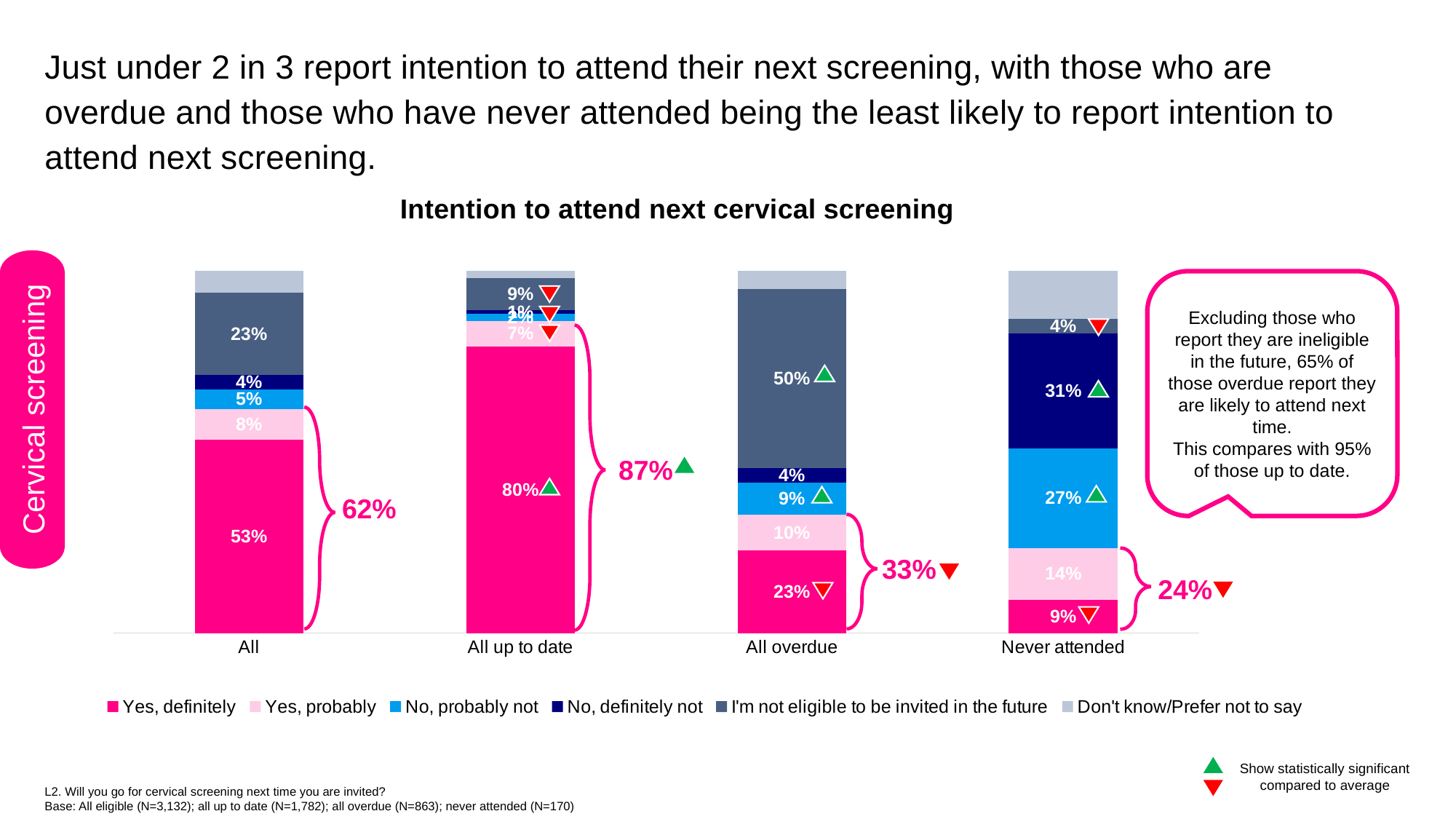
What is the value for "I'm not eligible to be invited in the future" in the All overdue category? 50% What is the title of the chart? Intention to attend next cervical screening Which category has the lowest value for "Yes, definitely"? Never attended How many series does the legend list? 6 What is the difference between the "Yes, definitely" values for All up to date and All overdue? 57 percentage points What combined intention-to-attend percentage is shown by the bracket for the All category? 62% How many categories are shown on the x axis? 4 What is the value for "Yes, definitely" in the All category? 53% What is the value for "No, definitely not" in the Never attended category? 31% What kind of chart is shown on the slide? Stacked bar chart Which category has the larger value for "No, probably not": Never attended or All overdue? Never attended Which category has the highest value for "Yes, definitely"? All up to date